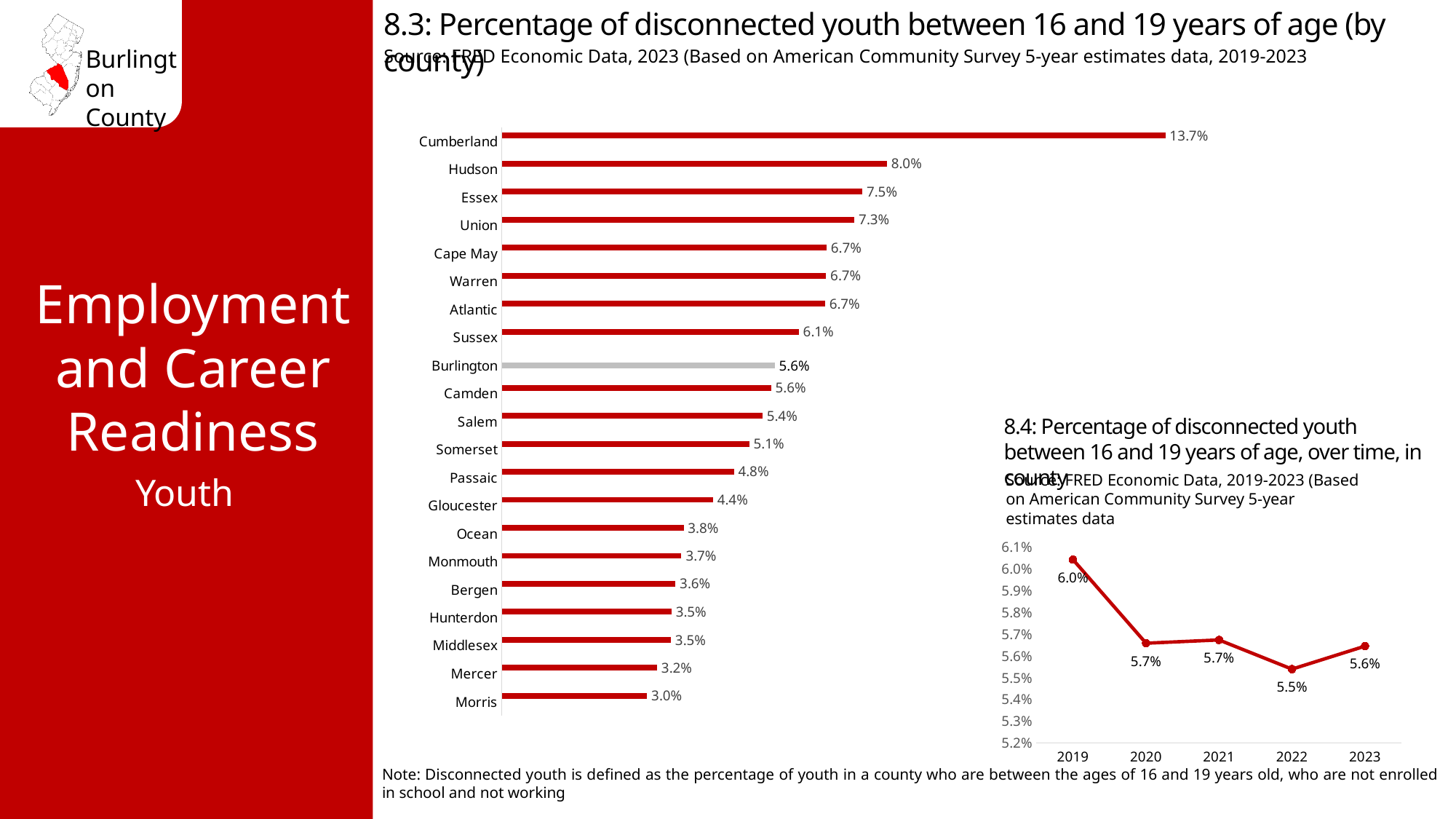
In the chart 8.4 (over time), what is the difference between the values for 2019 and 2023? 0.4% In the chart 8.4 (over time), which year has the highest value? 2019 In the chart 8.3 (by county), what is the difference between the values for Cumberland and Hudson? 5.7% In the chart 8.3 (by county), how many counties are shown? 21 In the chart 8.4 (over time), what is the value for 2022? 5.5% In the chart 8.3 (by county), which county has the highest percentage of disconnected youth? Cumberland What kind of chart is chart 8.3 (by county)? Bar chart In the chart 8.3 (by county), what is the percentage of disconnected youth for Burlington? 5.6% In the chart 8.3 (by county), which county has the lowest percentage of disconnected youth? Morris In the chart 8.3 (by county), what is the value for Gloucester? 4.4% In the chart 8.3 (by county), which has a higher value, Essex or Union? Essex What kind of chart is chart 8.4 (over time)? Line chart